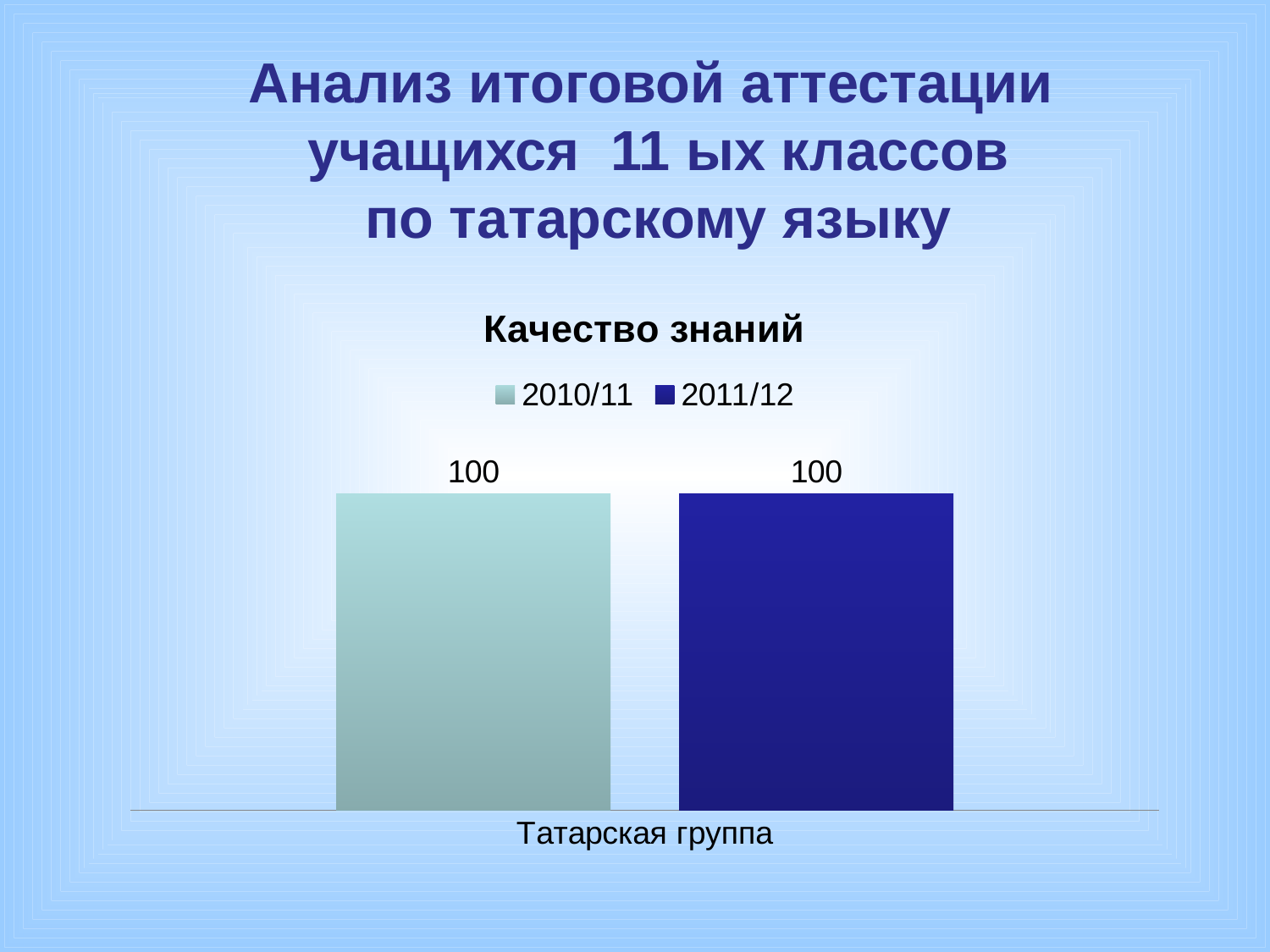
How many categories are shown on the x axis? 1 What is the title of the chart? Качество знаний What is the label of the category on the x axis? Татарская группа How many series does the legend list? 2 What is the difference between the 2011/12 and 2010/11 values for Татарская группа? 0 What is the value for 2011/12 for Татарская группа? 100 What is the value for 2010/11 for Татарская группа? 100 What kind of chart is shown on the slide? bar chart Which series is shown in dark blue? 2011/12 Did the value for Татарская группа change from 2010/11 to 2011/12? No